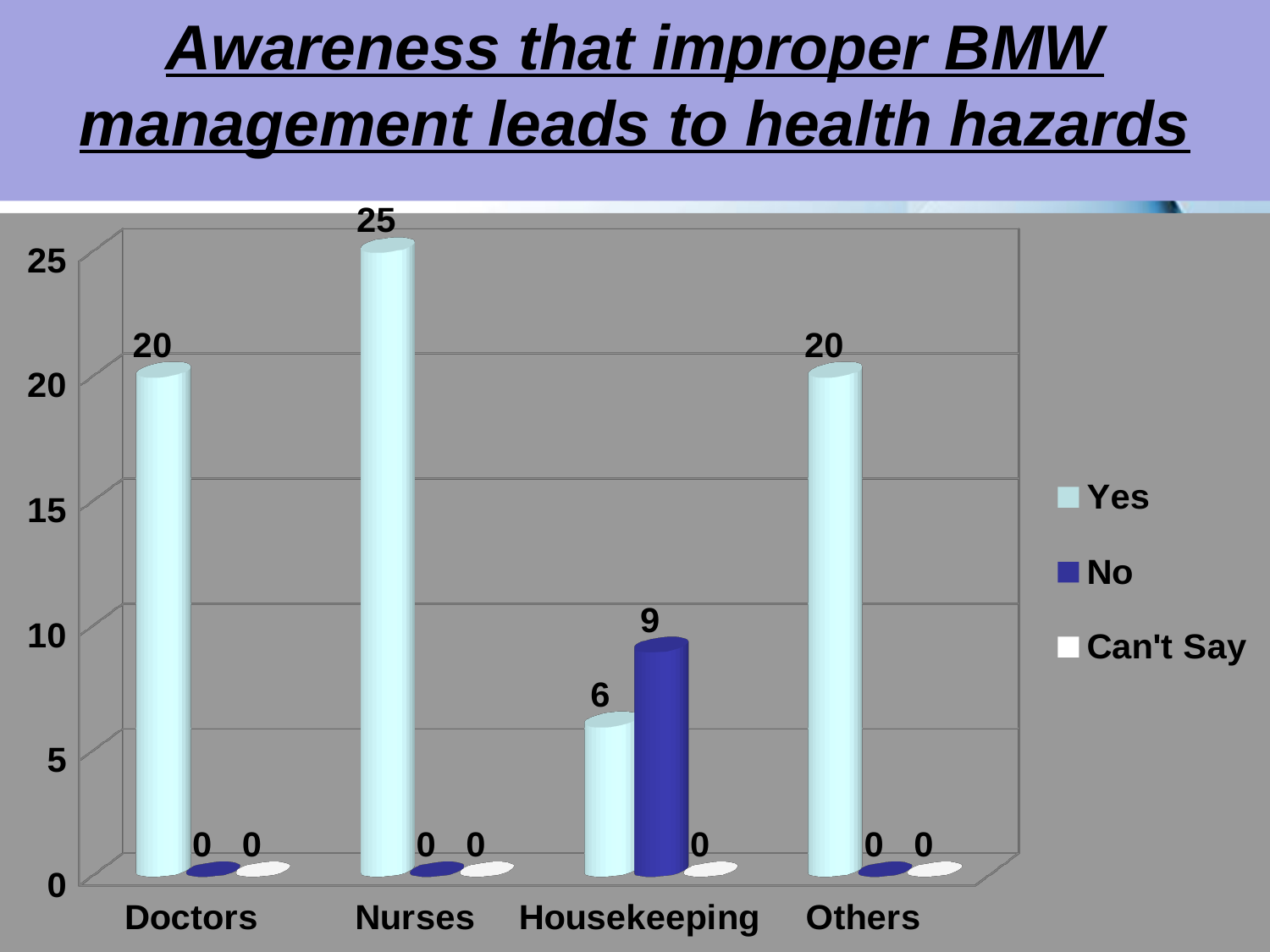
For Housekeeping, which is larger, the 'Yes' value or the 'No' value? No What is the difference between the 'Yes' values for Nurses and Doctors? 5 How many series does the legend list? 3 How many categories are shown on the x axis? 4 What kind of chart is shown on the slide? Bar chart What is the 'Yes' value for Nurses? 25 What is the 'No' value for Housekeeping? 9 What is the 'Yes' value for Housekeeping? 6 What is the 'Can't Say' value for Doctors? 0 Which category has the highest 'Yes' value? Nurses Which category is the only one with a non-zero 'No' value? Housekeeping Which category has the lowest 'Yes' value? Housekeeping